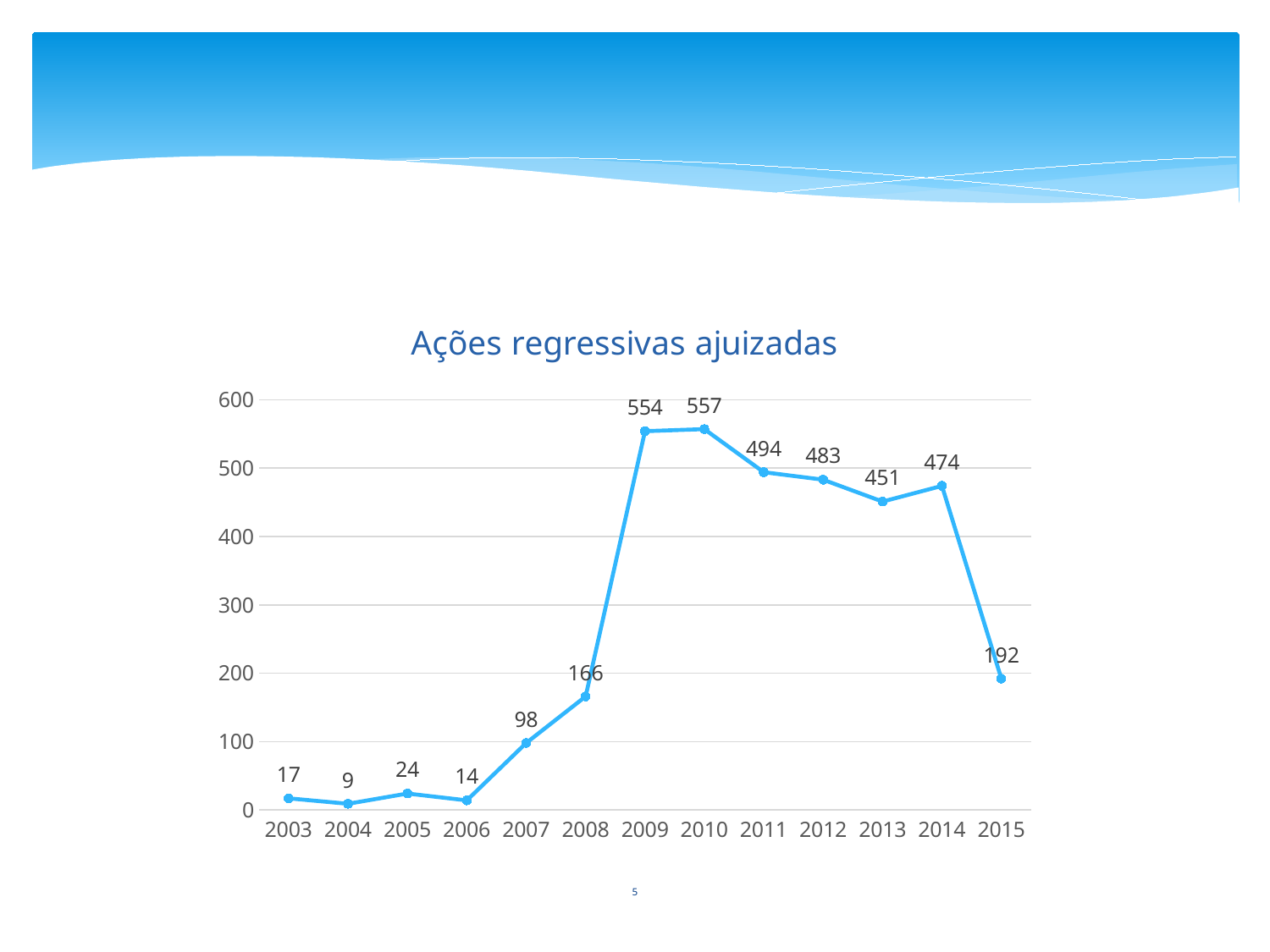
How many years are plotted on the chart? 13 What is the value for 2015? 192 What kind of chart is shown? line chart Which year has the lowest value? 2004 Which is larger, the value for 2011 or the value for 2012? 2011 What is the difference between the values for 2008 and 2009? 388 Which year has the highest value? 2010 Is the value for 2013 greater or less than 400? greater What is the title of the chart? Ações regressivas ajuizadas What is the difference between the values for 2014 and 2015? 282 What is the value for 2007? 98 What is the value for 2009? 554